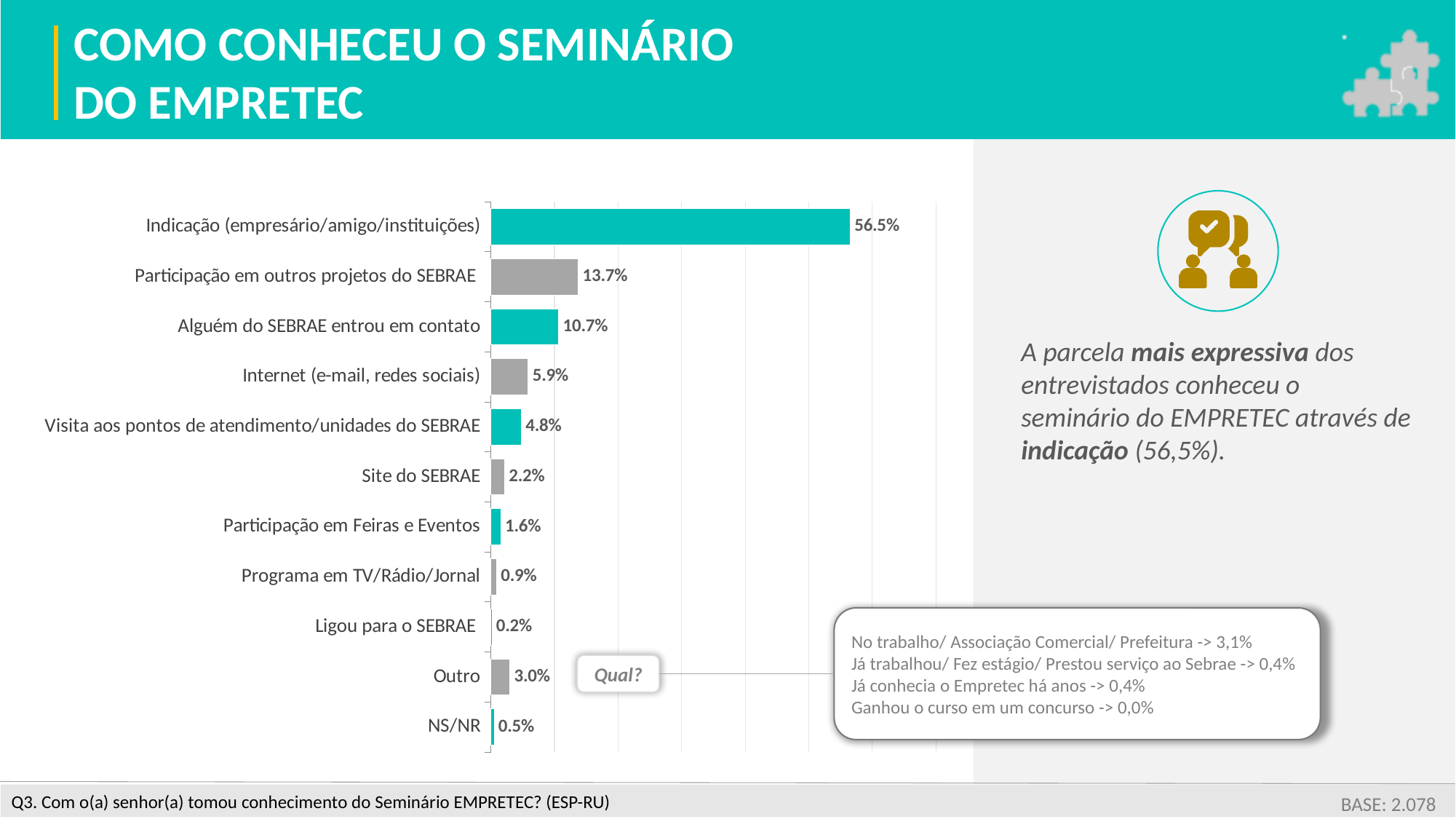
Which category has the lowest value? Ligou para o SEBRAE What kind of chart is shown on the slide? bar chart Which category has the highest value? Indicação (empresário/amigo/instituições) How many categories are shown in the chart? 11 What is the value for "NS/NR"? 0.5% What is the difference between the values for "Indicação (empresário/amigo/instituições)" and "Participação em outros projetos do SEBRAE"? 42.8% What is the value for "Participação em outros projetos do SEBRAE"? 13.7% What is the value for "Outro"? 3.0% What is the difference between the values for "Participação em outros projetos do SEBRAE" and "Alguém do SEBRAE entrou em contato"? 3.0% What is the value for "Indicação (empresário/amigo/instituições)"? 56.5% Which is larger, the value for "Site do SEBRAE" or the value for "Outro"? Outro What is the value for "Internet (e-mail, redes sociais)"? 5.9%